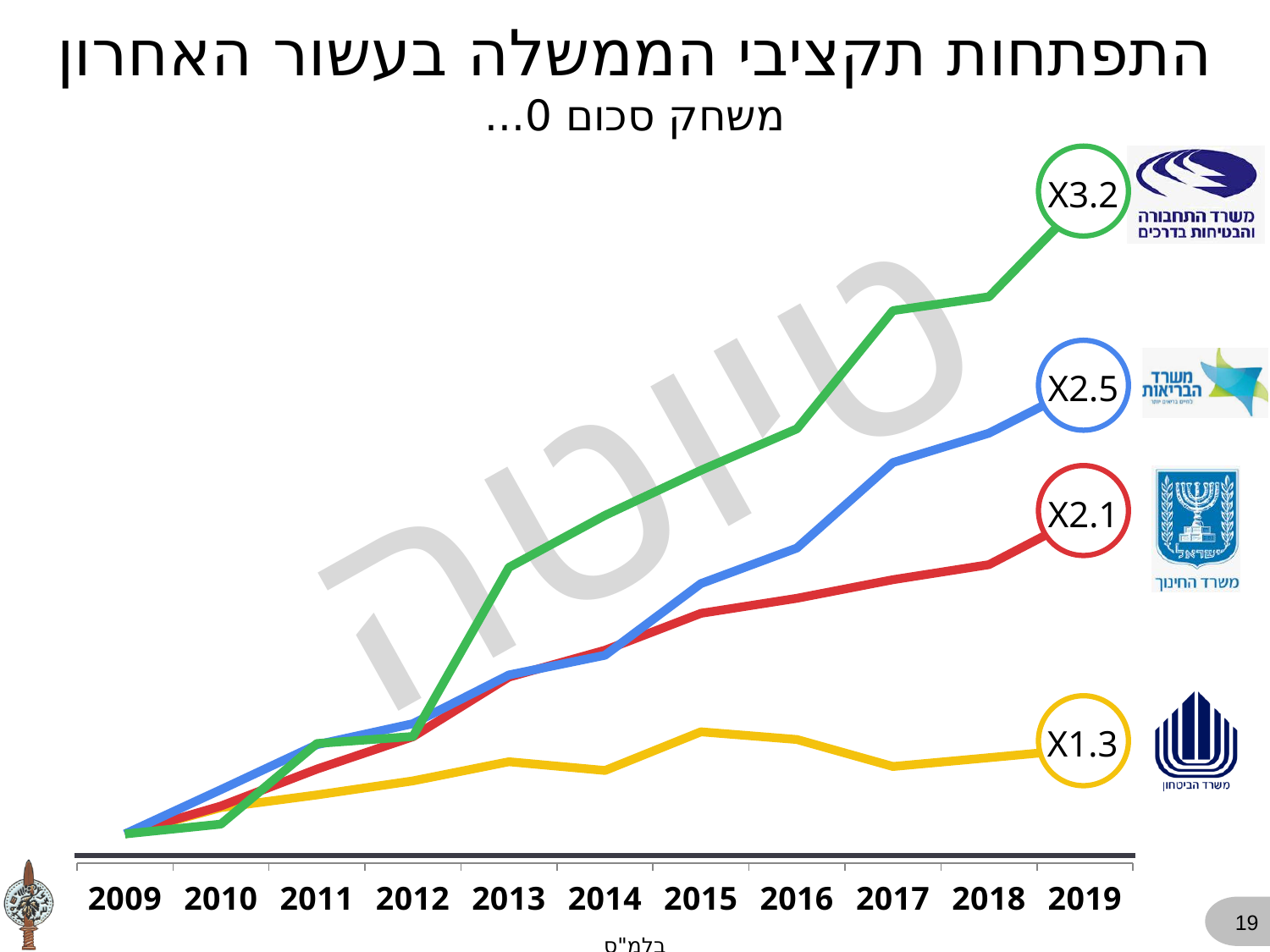
What is the final value shown for the blue line (משרד הבריאות) in 2019? X2.5 How many years are shown on the x axis? 11 What is the difference between the 2019 values of the green line (X3.2) and the yellow line (X1.3)? 1.9 Does the green line generally rise or fall from 2009 to 2019? rise Which line has the lowest value in 2019? the yellow line (משרד הביטחון), X1.3 Which is larger in 2019, the blue line's value or the red line's value? the blue line (X2.5) How many lines are plotted on the chart? 4 Which line has the highest value in 2019? the green line (משרד התחבורה), X3.2 What is the final value shown for the red line (משרד החינוך) in 2019? X2.1 What is the final value shown for the green line (משרד התחבורה) in 2019? X3.2 What is the final value shown for the yellow line (משרד הביטחון) in 2019? X1.3 What kind of chart is shown on the slide? line chart